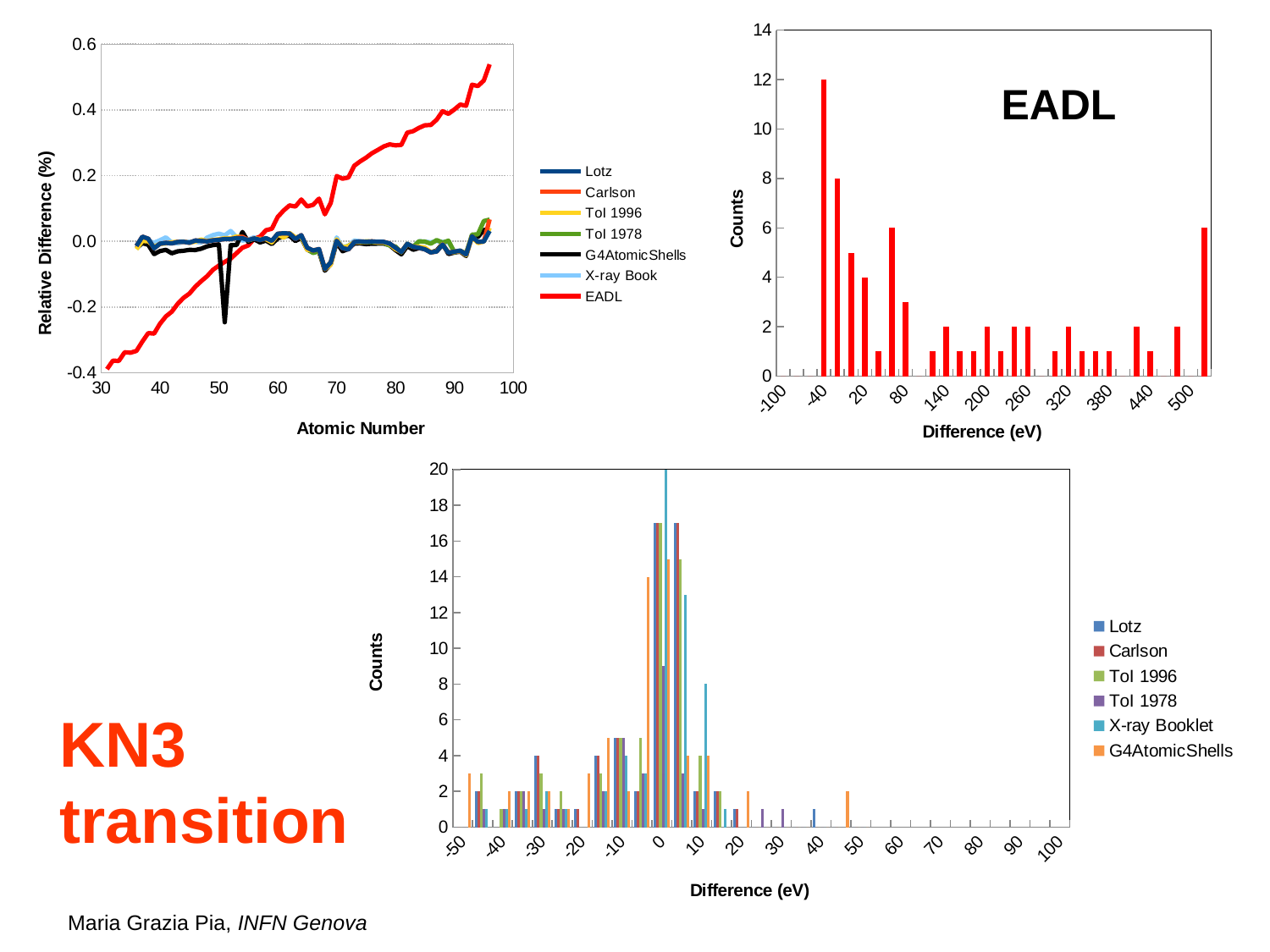
In the top-right EADL chart, is the tallest bar greater or less than 10 counts? greater What kind of chart is the top-left chart (Relative Difference vs Atomic Number)? line chart How many series does the legend of the top-left chart list? 7 In the top-right EADL chart, at which Difference (eV) value is the tallest bar? -40 What is the x-axis title of the top-left chart? Atomic Number What kind of chart is the top-right EADL chart? bar chart In the top-left chart, does the EADL series rise or fall as the atomic number increases? rises What is the y-axis title of the top-right EADL chart? Counts In the top-left chart, is the EADL value at atomic number 40 greater or less than 0? less In the bottom chart, which series has the tallest bar? X-ray Booklet How many series does the legend of the bottom chart list? 6 In the top-left chart, is the EADL value at atomic number 90 greater or less than 0.2? greater